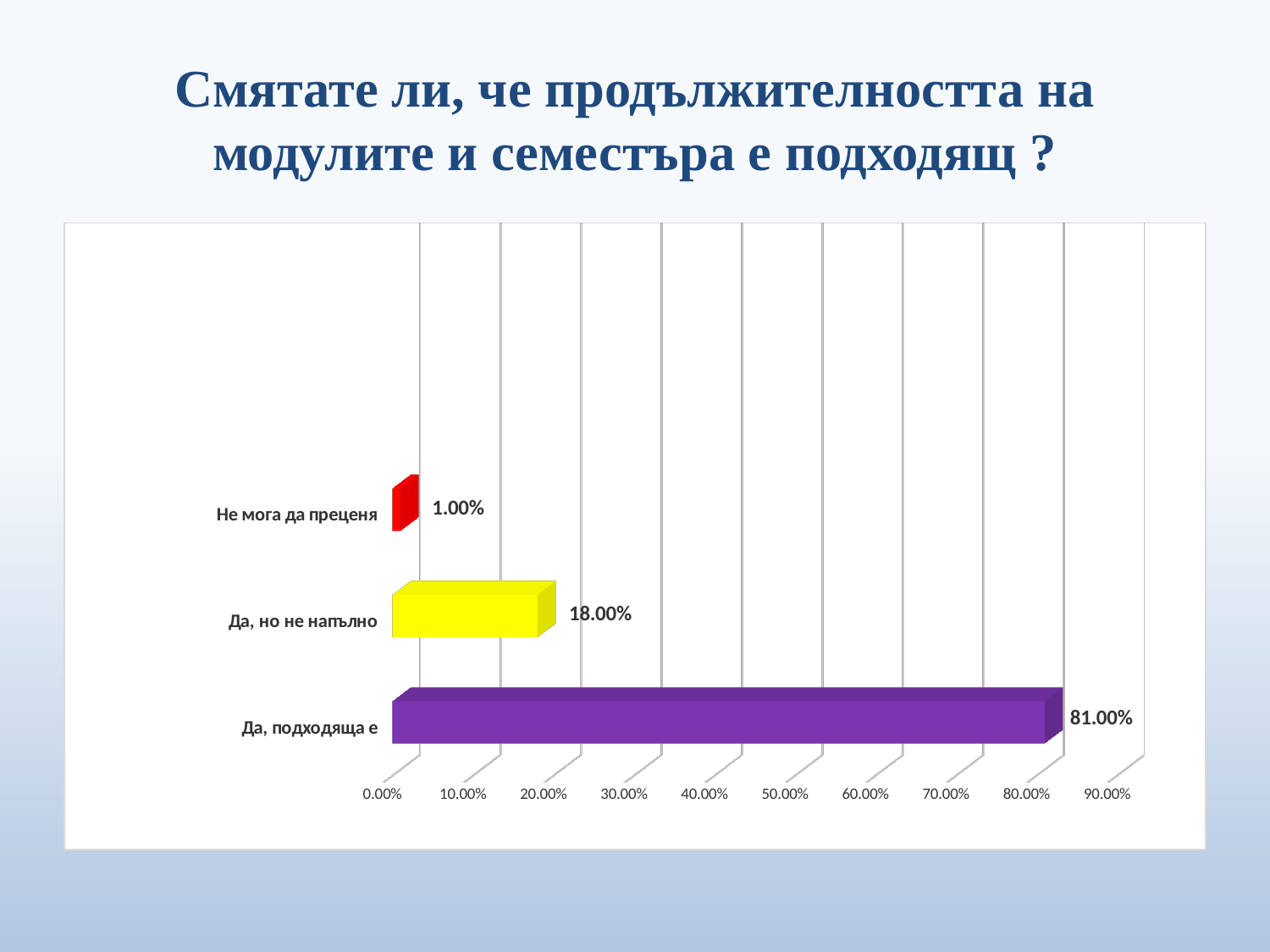
Which category has the highest value? Да, подходяща е What is the value for "Да, но не напълно"? 18.00% How many categories are shown in the chart? 3 Is the value for "Да, подходяща е" greater or less than 50.00%? greater What is the difference between the values for "Да, подходяща е" and "Да, но не напълно"? 63.00% What kind of chart is shown on the slide? bar chart Which is larger, the value for "Да, но не напълно" or the value for "Не мога да преценя"? Да, но не напълно What colour is the bar for "Да, подходяща е"? purple What is the difference between the values for "Да, но не напълно" and "Не мога да преценя"? 17.00% What is the value for "Не мога да преценя"? 1.00% Which category has the lowest value? Не мога да преценя What is the value for "Да, подходяща е"? 81.00%